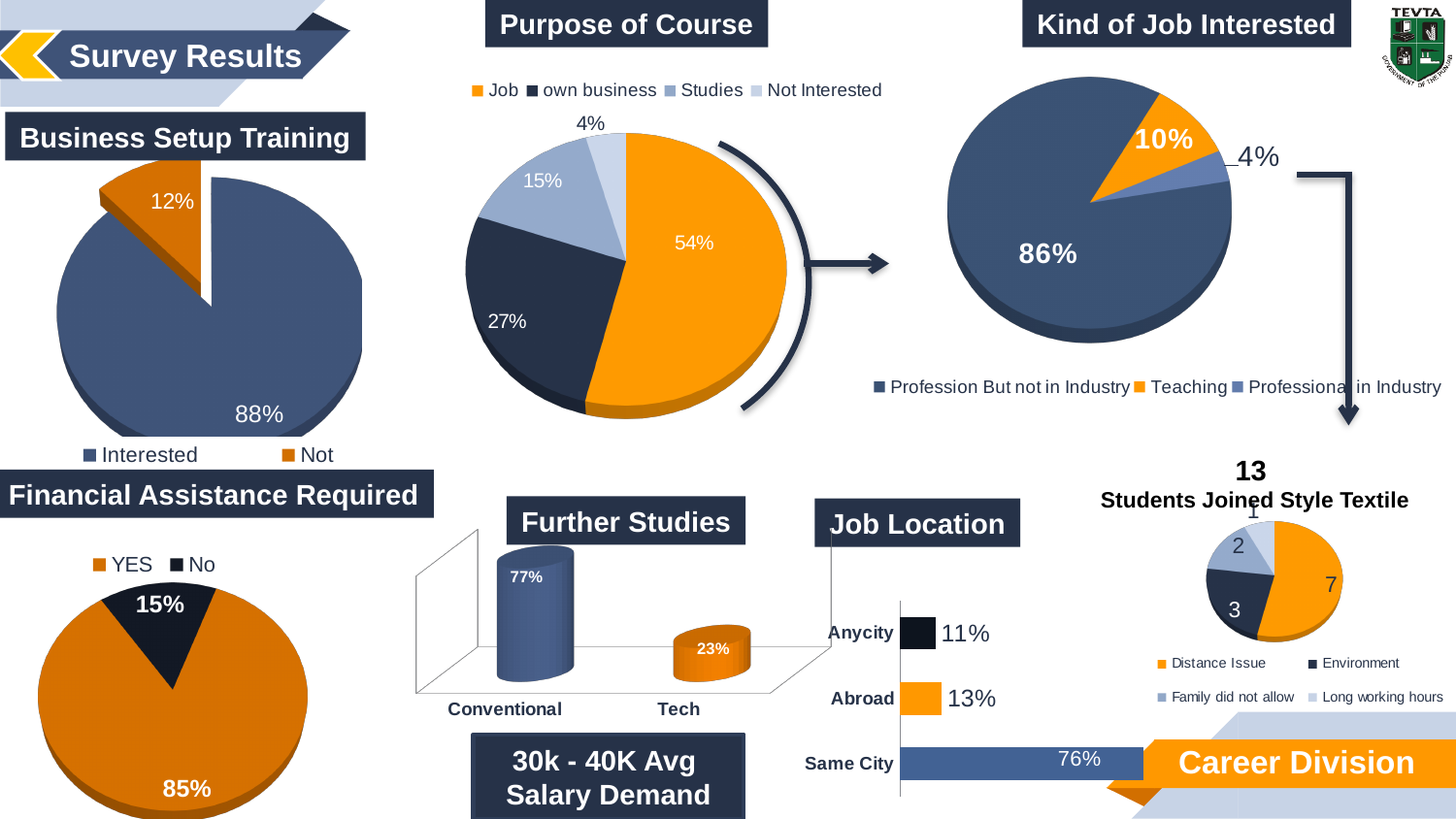
In the Further Studies chart, what is the value for Tech? 23% In the Job Location chart, what is the value for Same City? 76% In the Purpose of Course chart, how many categories does the legend list? 4 In the Business Setup Training chart, what share of respondents are Interested? 88% In the Kind of Job Interested chart, which category has the smallest share? Professional in Industry In the Job Location chart, which is larger, Anycity or Abroad? Abroad In the Financial Assistance Required chart, what is the difference between YES and No? 70% In the Students Joined Style Textile chart, what is the value for Environment? 3 What kind of chart is the Further Studies chart? bar chart In the Kind of Job Interested chart, what is the value for Teaching? 10% In the Purpose of Course chart, what is the value for own business? 27% In the Purpose of Course chart, which category has the largest share? Job